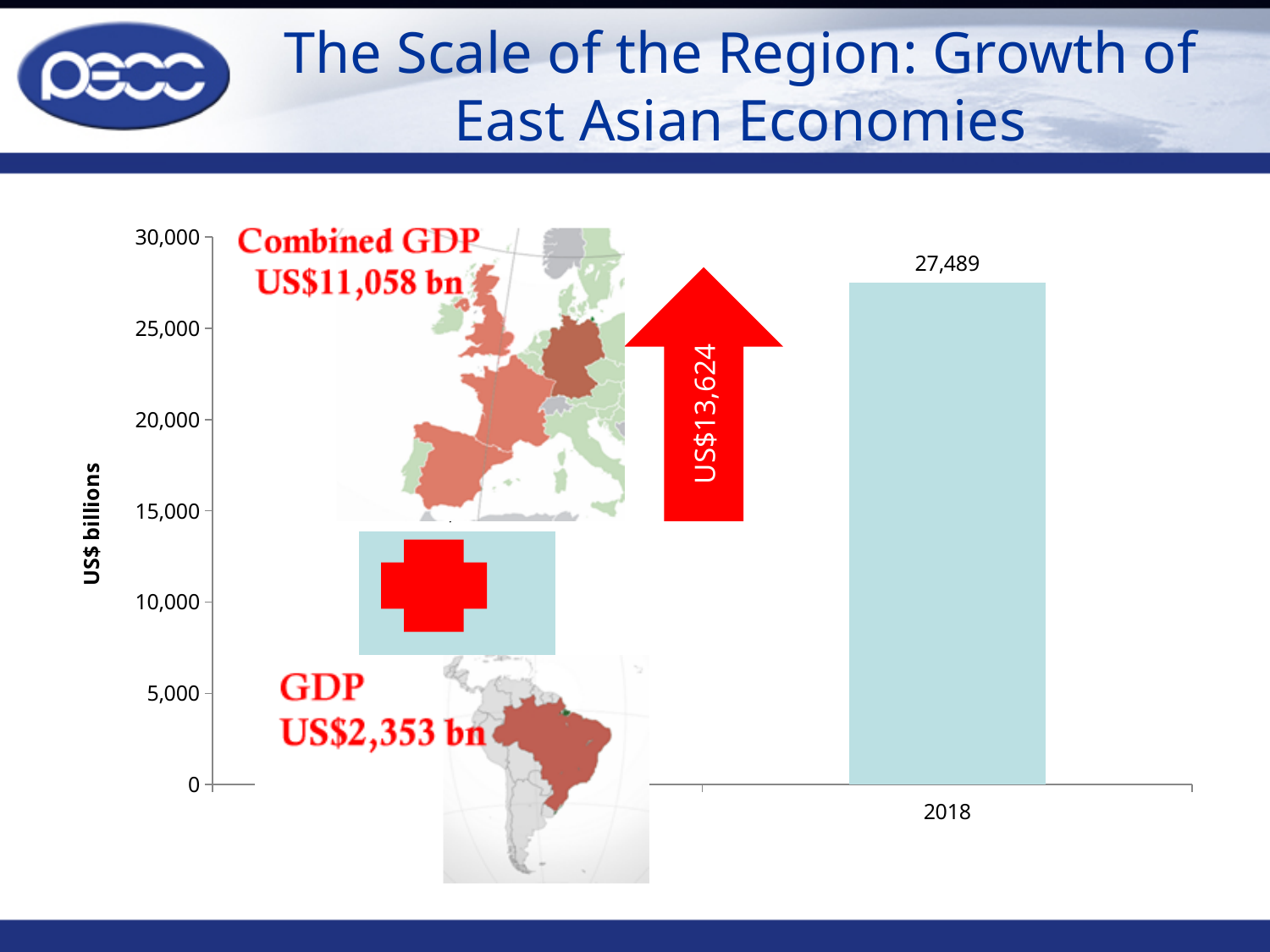
What is the value of the bar for 2018? 27,489 What kind of chart is shown on the slide? bar chart Is the value for 2018 greater or less than 30,000? less What is the highest tick value shown on the vertical axis? 30,000 Is the value for 2018 greater or less than 25,000? greater What is the title of the vertical axis? US$ billions Which year is labelled on the horizontal axis under the visible bar? 2018